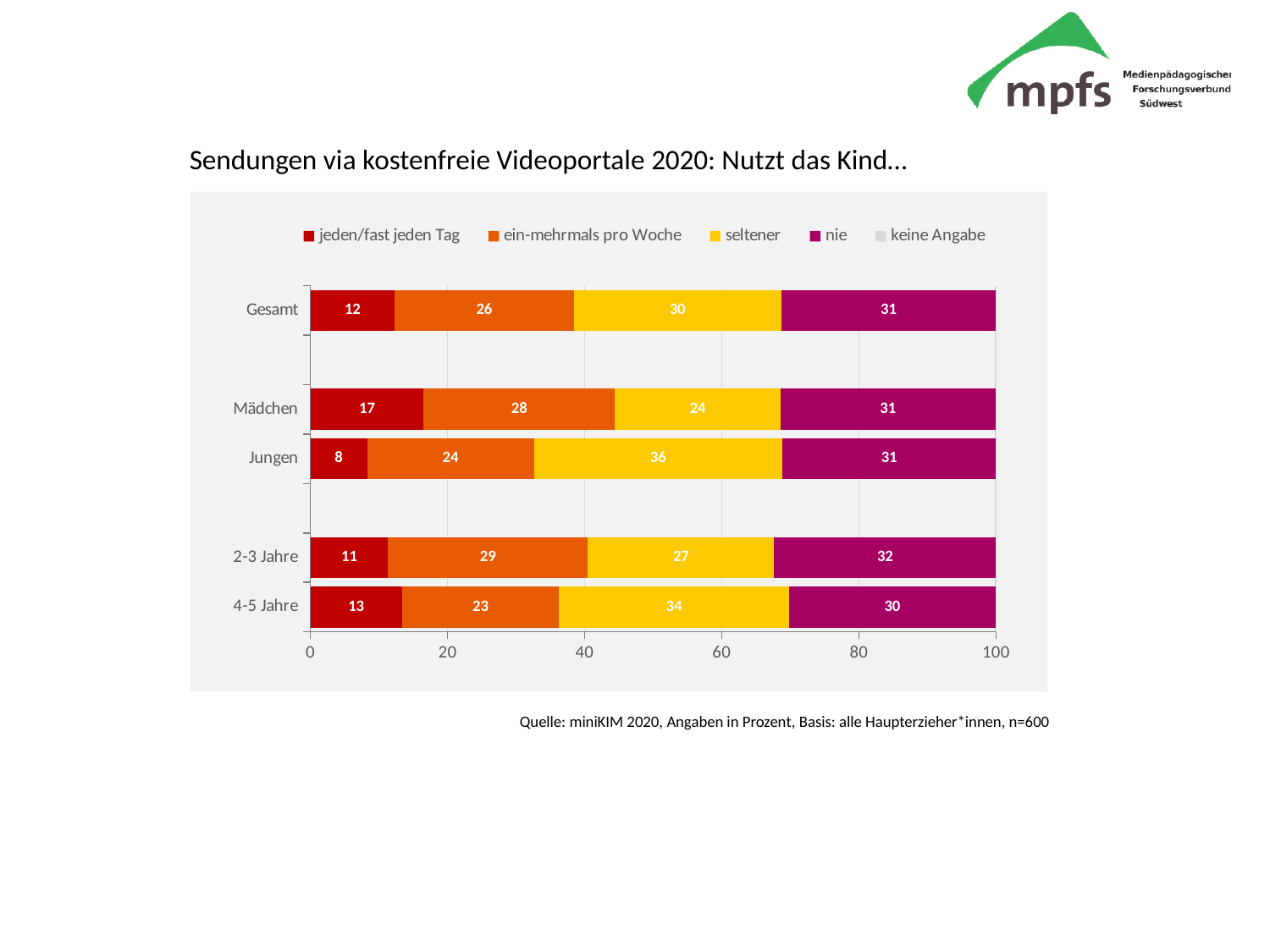
What is the value for "jeden/fast jeden Tag" for Mädchen? 17 What is the value for "ein-mehrmals pro Woche" for 4-5 Jahre? 23 What kind of chart is shown on the slide? Stacked bar chart What is the difference between the "seltener" values for Jungen and Mädchen? 12 What is the value for "nie" for 2-3 Jahre? 32 Which is larger: the "ein-mehrmals pro Woche" value for 2-3 Jahre or for 4-5 Jahre? 2-3 Jahre Which category has the highest value for "jeden/fast jeden Tag"? Mädchen What is the value for "seltener" for Jungen? 36 How many series does the legend list? 5 Which category has the lowest value for "jeden/fast jeden Tag"? Jungen What is the title of the chart? Sendungen via kostenfreie Videoportale 2020: Nutzt das Kind… How many categories are shown on the y axis? 5